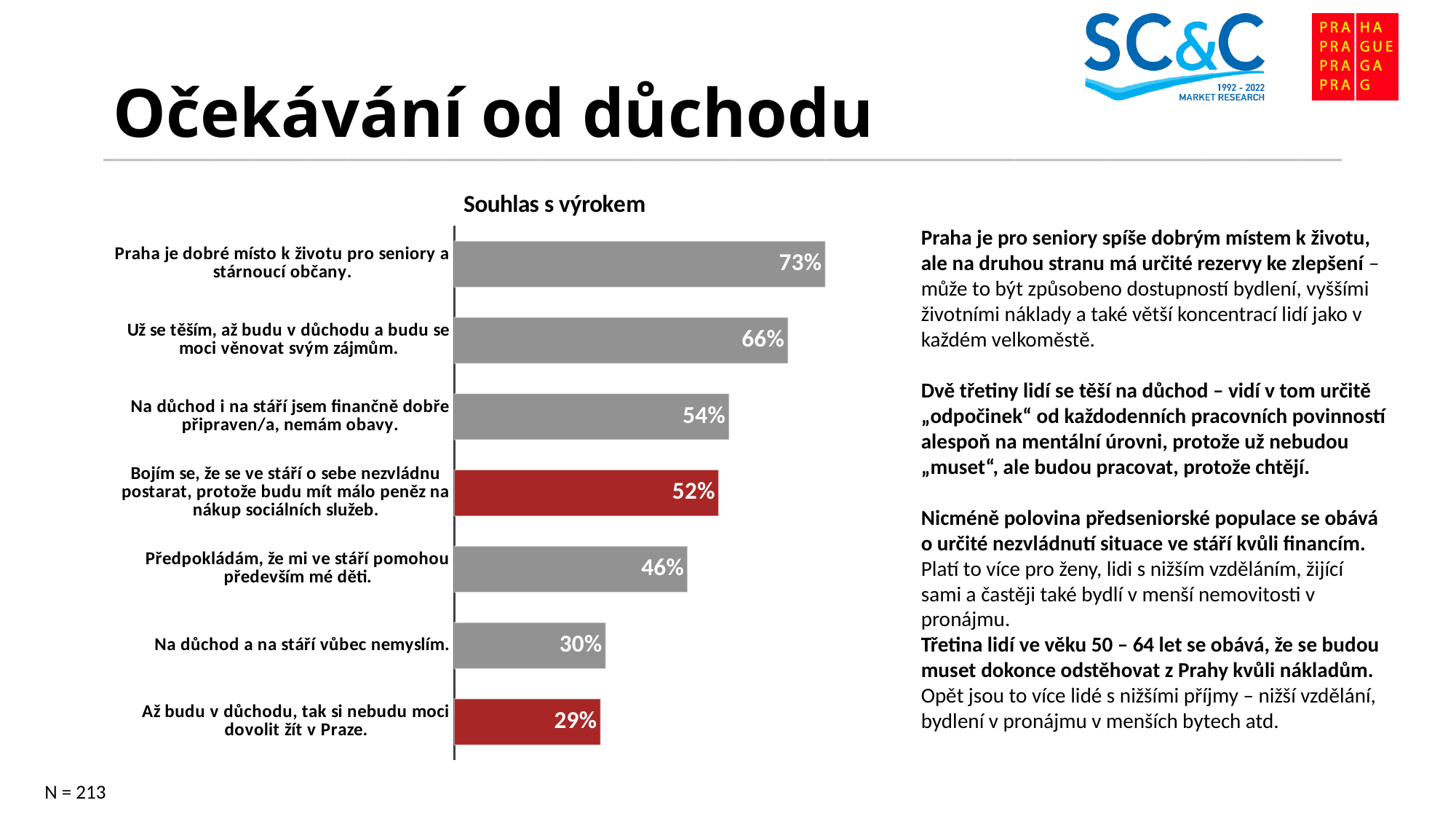
What is the difference between the values for "Už se těším, až budu v důchodu a budu se moci věnovat svým zájmům." and "Předpokládám, že mi ve stáří pomohou především mé děti."? 20 percentage points How many bars in the chart are coloured red? 2 How many statements are shown in the chart? 7 Which statement has the lowest level of agreement? Až budu v důchodu, tak si nebudu moci dovolit žít v Praze. What is the difference between the highest and lowest values in the chart? 44 percentage points What is the value for "Na důchod a na stáří vůbec nemyslím."? 30% What is the title of the chart? Souhlas s výrokem What kind of chart is shown on the slide? Bar chart Which has a higher value: "Na důchod i na stáří jsem finančně dobře připraven/a, nemám obavy." or "Předpokládám, že mi ve stáří pomohou především mé děti."? Na důchod i na stáří jsem finančně dobře připraven/a, nemám obavy. What is the value for "Bojím se, že se ve stáří o sebe nezvládnu postarat, protože budu mít málo peněz na nákup sociálních služeb."? 52% Which statement has the highest level of agreement? Praha je dobré místo k životu pro seniory a stárnoucí občany. What percentage agrees with the statement "Praha je dobré místo k životu pro seniory a stárnoucí občany."? 73%